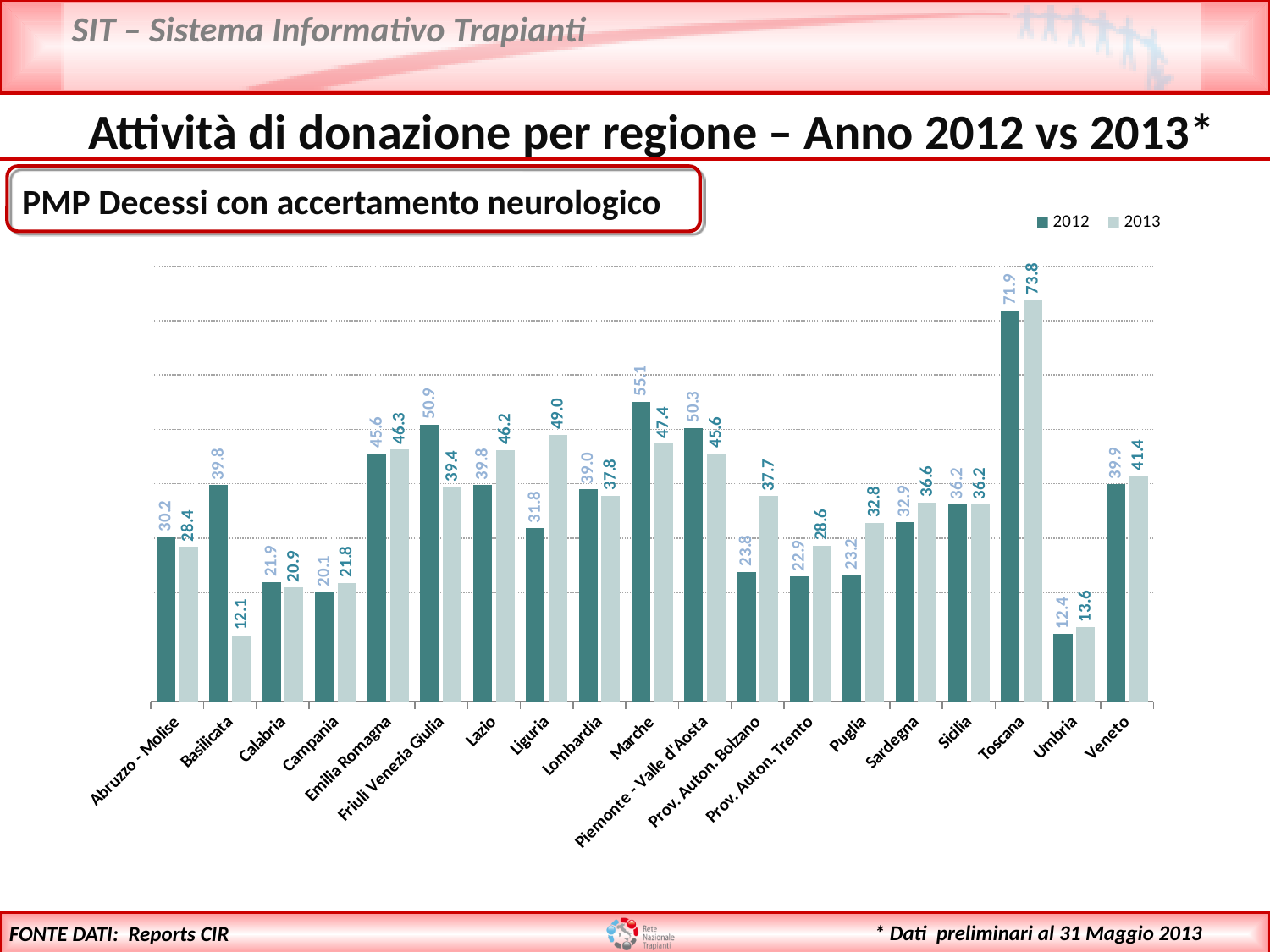
What is the 2013 value for Basilicata? 12.1 Which region has the lowest 2012 value? Umbria Which is larger for Prov. Auton. Bolzano, the 2012 value or the 2013 value? 2013 What is the 2012 value for Marche? 55.1 How many series does the legend list? 2 How many regions are shown on the x axis? 19 Which is larger for Friuli Venezia Giulia, the 2012 value or the 2013 value? 2012 What is the difference between the 2012 and 2013 values for Basilicata? 27.7 What is the 2013 value for Liguria? 49.0 What kind of chart is shown on the slide? Bar chart What is the 2012 value for Toscana? 71.9 Which region has the highest 2013 value? Toscana